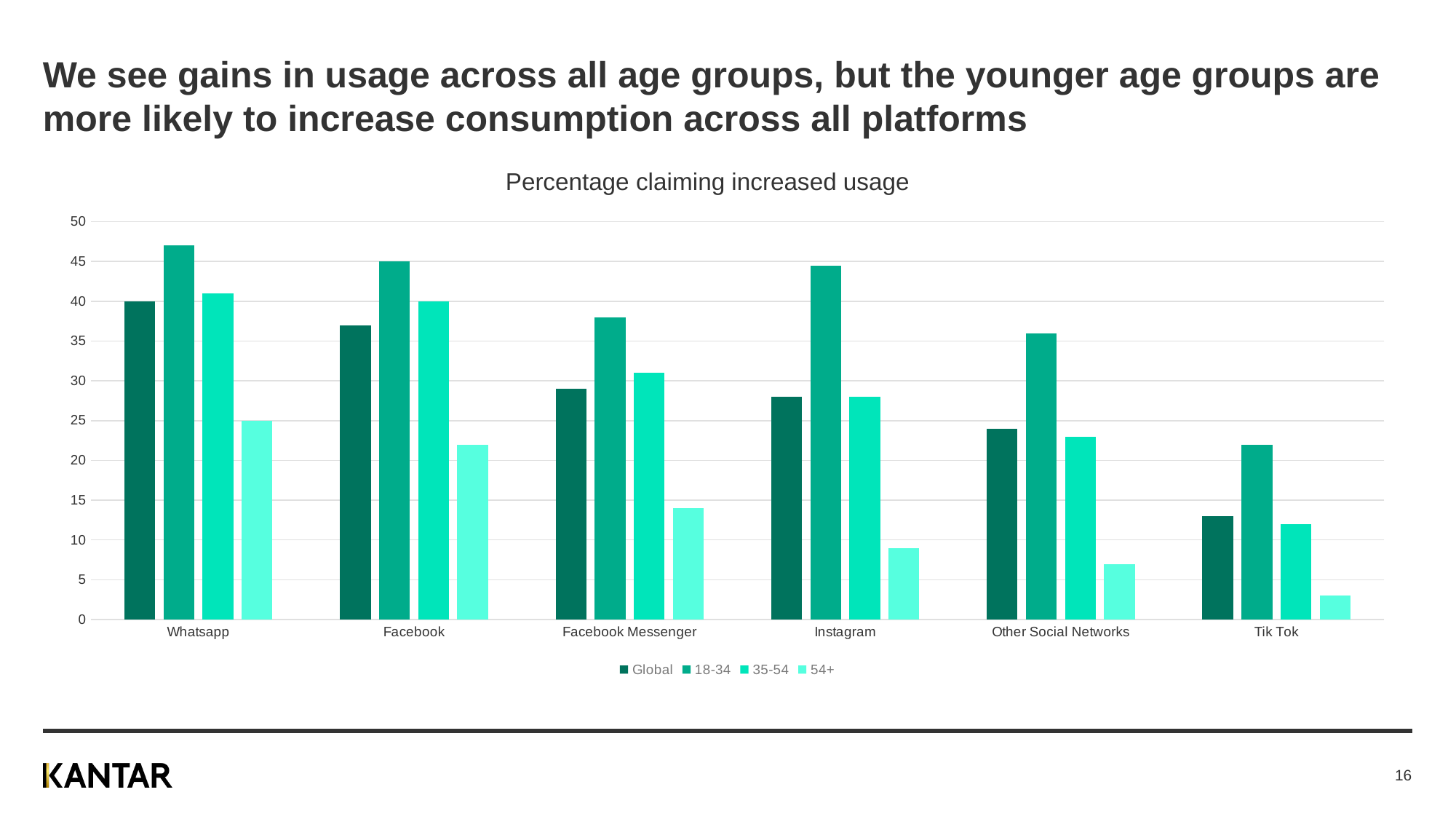
Which series is shown in the darkest green colour? Global For Other Social Networks, which is larger: the Global value or the 35-54 value? Global Which platform has the highest value for the 18-34 series? Whatsapp Which platform has the lowest value for the Global series? Tik Tok Which platform has the lowest value for the 54+ series? Tik Tok What kind of chart is shown on the slide? bar chart How many series does the legend list? 4 Is the value for the 54+ series on Facebook Messenger greater or less than 15? less How many platforms (categories) are shown on the x axis? 6 Is the value for the 18-34 series on Tik Tok greater or less than 20? greater What is the title of the chart? Percentage claiming increased usage Is the value for the 18-34 series on Instagram greater or less than 40? greater